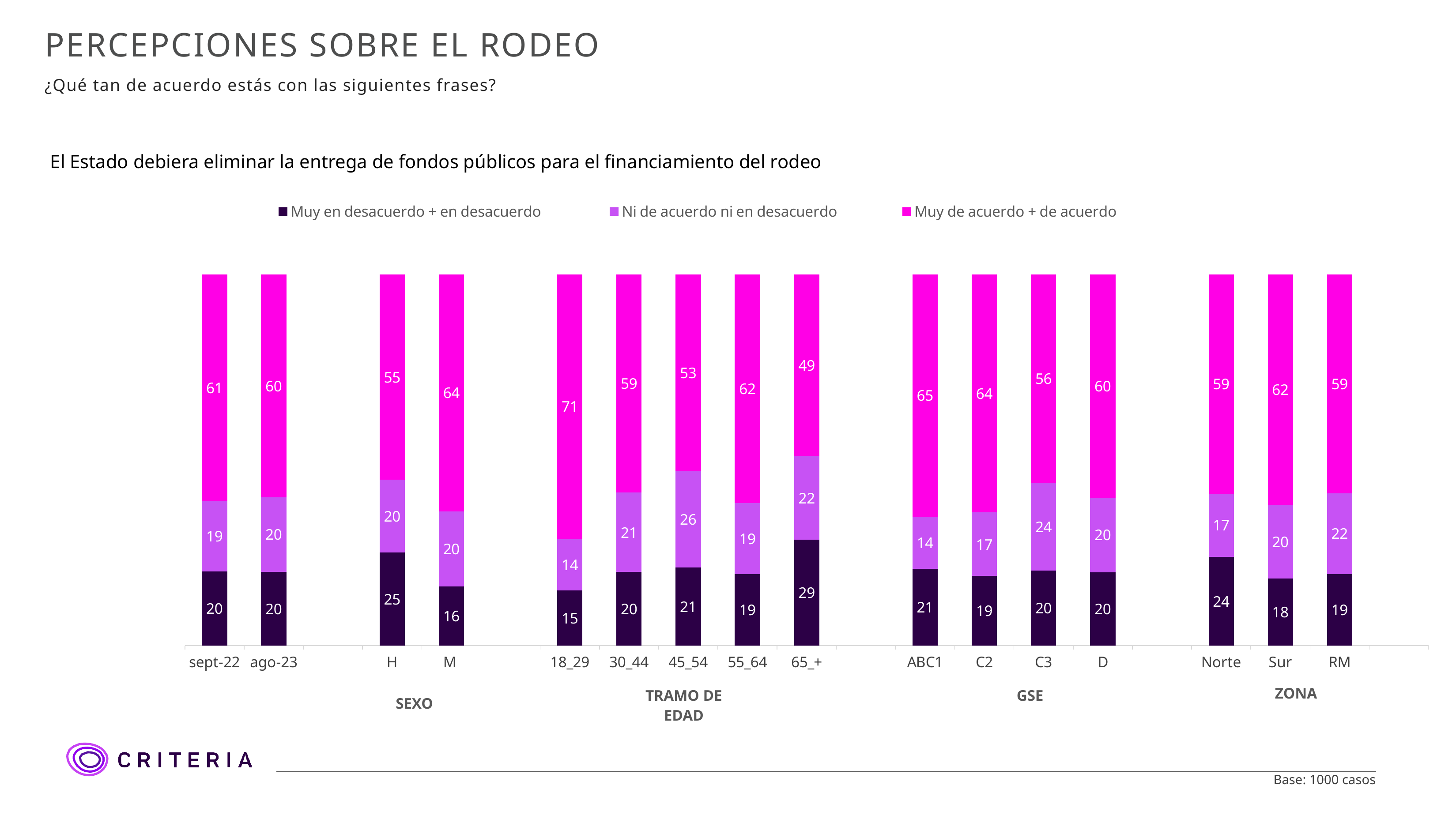
What kind of chart is shown on the slide? Stacked bar chart What is the value of 'Muy de acuerdo + de acuerdo' for the 18_29 age group? 71 Which has a larger 'Muy en desacuerdo + en desacuerdo' value, Norte or Sur? Norte What is the total of the stacked bar for ABC1? 100 What is the difference between the 'Muy de acuerdo + de acuerdo' values for M and H? 9 Which category has the highest 'Muy de acuerdo + de acuerdo' value? 18_29 Which category has the lowest 'Muy de acuerdo + de acuerdo' value? 65_+ What is the value of 'Ni de acuerdo ni en desacuerdo' for the 45_54 age group? 26 How many series does the legend list? 3 What is the value of 'Muy en desacuerdo + en desacuerdo' for the 65_+ age group? 29 How many categories (bars) are shown on the x axis? 16 What is the statement being evaluated in the chart? El Estado debiera eliminar la entrega de fondos públicos para el financiamiento del rodeo